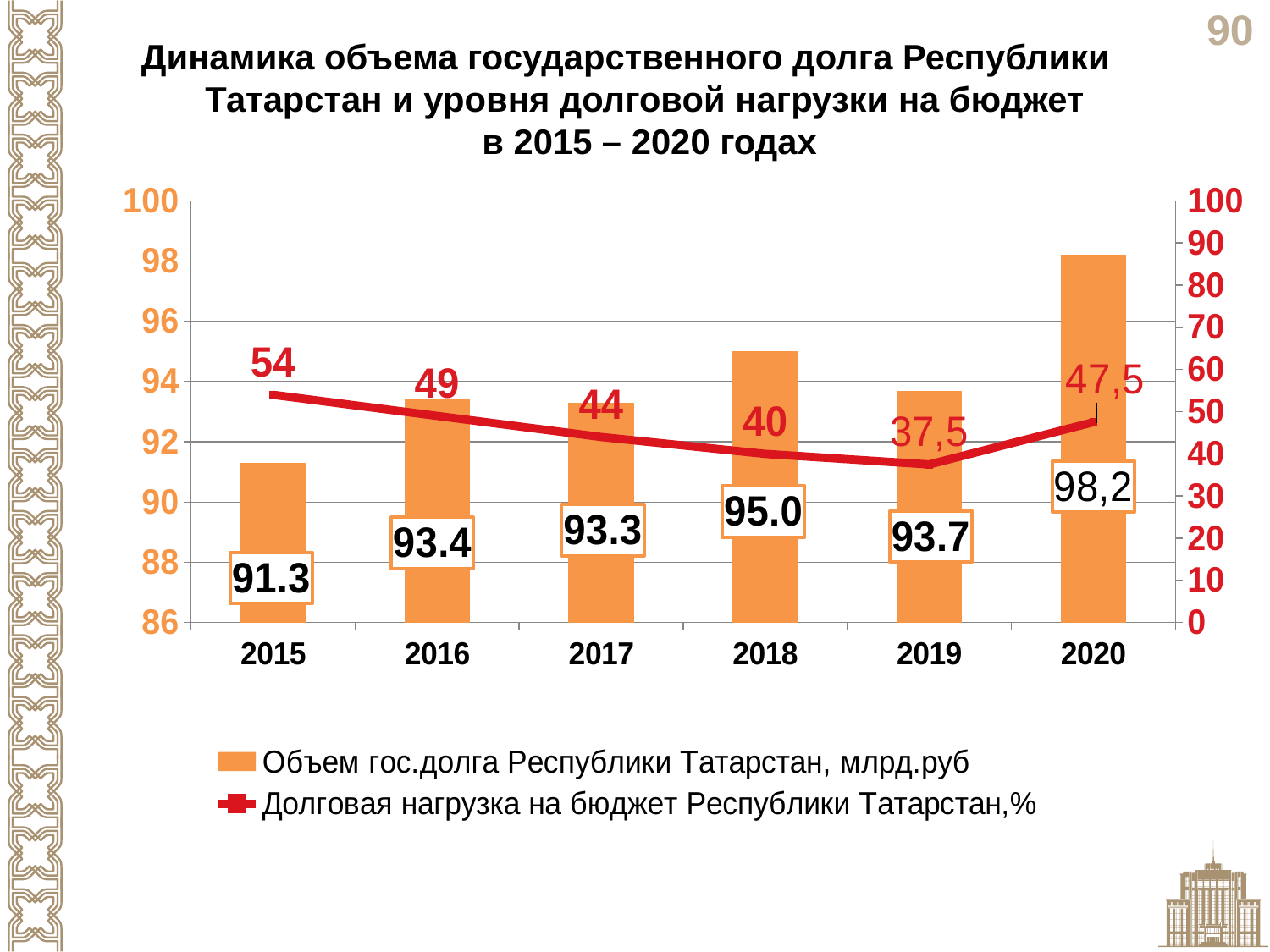
What is the value of the bar series (Объем гос.долга Республики Татарстан, млрд.руб) for 2015? 91.3 What is the difference between the bar values for 2018 and 2015? 3.7 What is the value of the line series (Долговая нагрузка на бюджет Республики Татарстан,%) for 2017? 44 Does the line series (Долговая нагрузка на бюджет) rise or fall from 2015 to 2019? fall Which year has the larger bar value, 2016 or 2019? 2019 In which year is the line series (Долговая нагрузка на бюджет) lowest? 2019 How many years are shown on the x axis? 6 What is the value of the line series (Долговая нагрузка на бюджет Республики Татарстан,%) for 2019? 37,5 How many series does the legend list? 2 What is the difference between the line values for 2015 and 2018? 14 What is the value of the bar series (Объем гос.долга Республики Татарстан, млрд.руб) for 2020? 98,2 In which year is the bar series (Объем гос.долга) highest? 2020